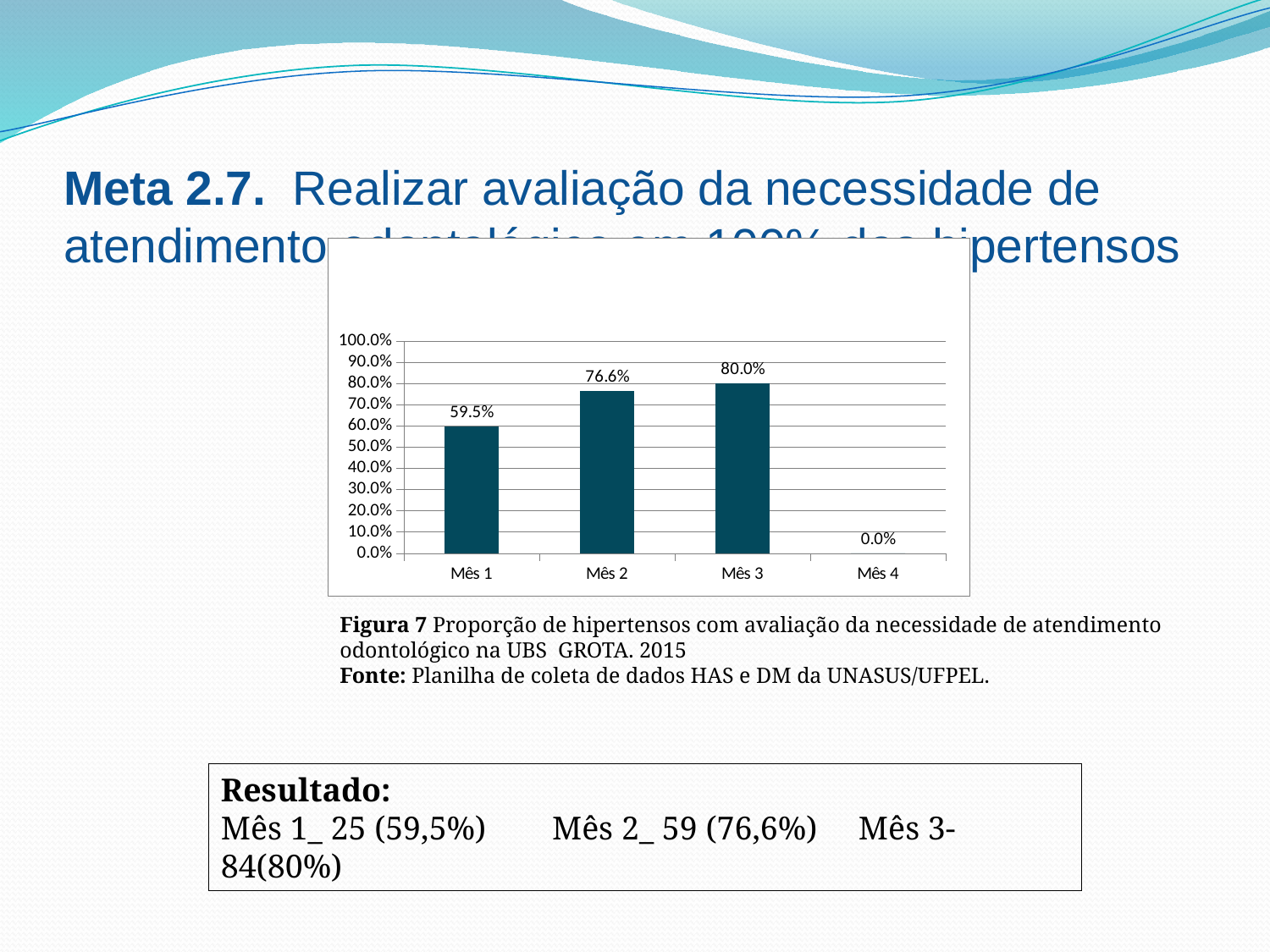
What is the difference between the values for Mês 3 and Mês 1? 20.5% What is the value for Mês 3? 80.0% What is the difference between the values for Mês 2 and Mês 1? 17.1% How many months are shown on the x axis? 4 Which month has the lowest value? Mês 4 Which month has the highest value? Mês 3 What is the value for Mês 1? 59.5% What is the value for Mês 2? 76.6% What kind of chart is shown on the slide? Bar chart Do the values rise or fall from Mês 1 to Mês 3? Rise Which is larger, the value for Mês 2 or the value for Mês 3? Mês 3 What is the value for Mês 4? 0.0%